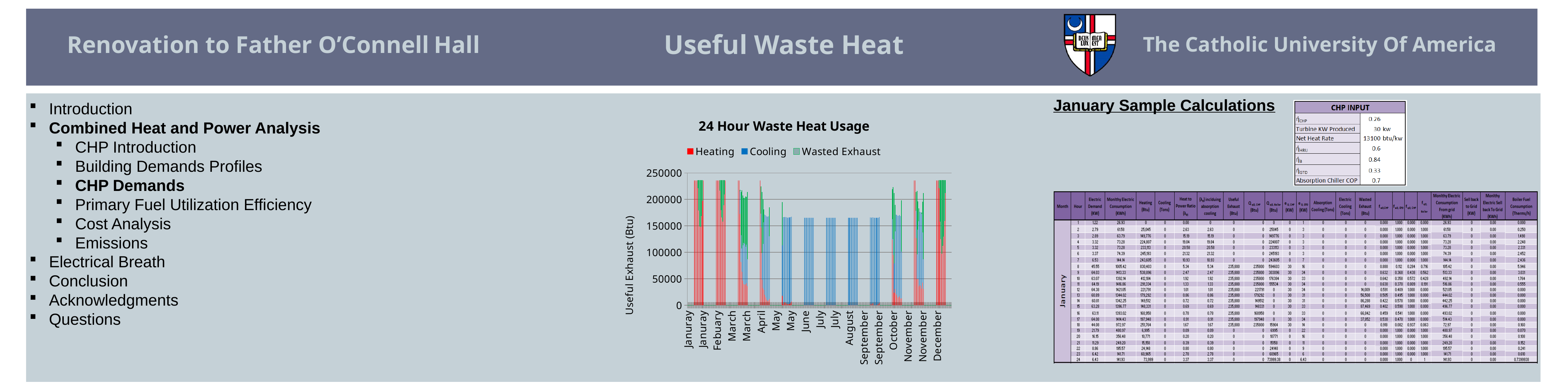
On the "24 Hour Waste Heat Usage" chart, are the Cooling values in June greater or less than 200000? less What is the label of the vertical axis on the "24 Hour Waste Heat Usage" chart? Useful Exhaust (Btu) On the "24 Hour Waste Heat Usage" chart, is the highest Heating value in January greater or less than 200000? greater On the "24 Hour Waste Heat Usage" chart, are the Cooling values in July greater or less than 150000? greater On the "24 Hour Waste Heat Usage" chart, which series is dominant in the summer months of June, July and August? Cooling What kind of chart is the "24 Hour Waste Heat Usage" chart? bar chart How many series does the legend of the "24 Hour Waste Heat Usage" chart list? 3 What is the maximum value shown on the vertical axis of the "24 Hour Waste Heat Usage" chart? 250000 What are the three series listed in the legend of the "24 Hour Waste Heat Usage" chart? Heating, Cooling, Wasted Exhaust On the "24 Hour Waste Heat Usage" chart, which is larger: the highest Heating value in January or the highest Cooling value in June? Heating in January How many distinct month names appear on the x axis of the "24 Hour Waste Heat Usage" chart? 12